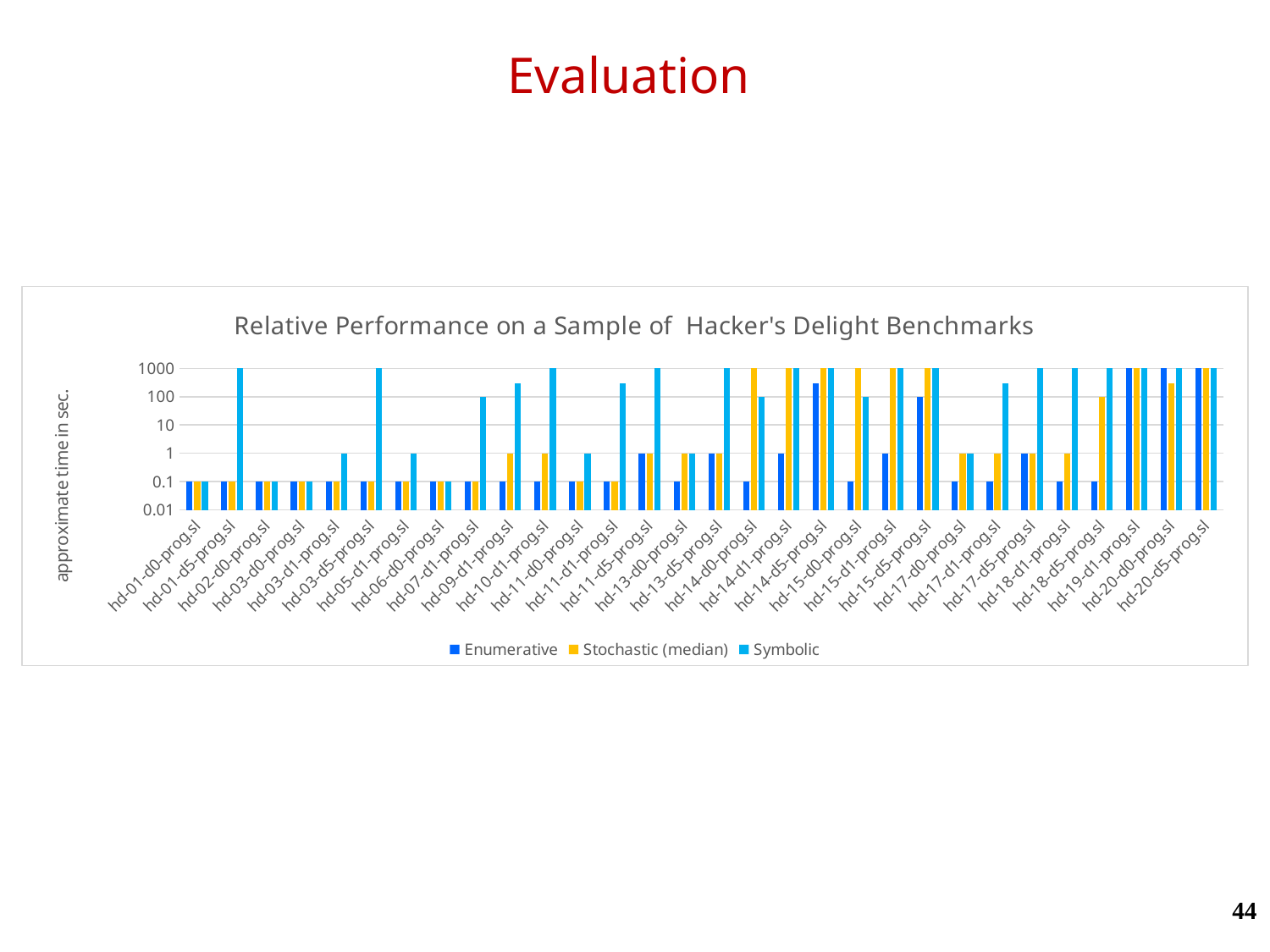
What kind of chart is shown on the slide? bar chart For hd-01-d5-prog.sl, which is larger: the Enumerative value or the Symbolic value? Symbolic What is the Stochastic (median) value for hd-14-d0-prog.sl? 1000 How many benchmark categories are shown on the x axis? 30 What is the difference between the Stochastic (median) value and the Symbolic value for hd-14-d0-prog.sl? 900 How many series does the legend list? 3 What is the Symbolic value for hd-01-d5-prog.sl? 1000 What is the label on the y axis of the chart? approximate time in sec. What is the Enumerative value for hd-01-d0-prog.sl? 0.1 What is the Symbolic value for hd-07-d1-prog.sl? 100 Is the Enumerative value for hd-14-d5-prog.sl greater or less than 100? greater Is the Symbolic value for hd-09-d1-prog.sl greater or less than 100? greater